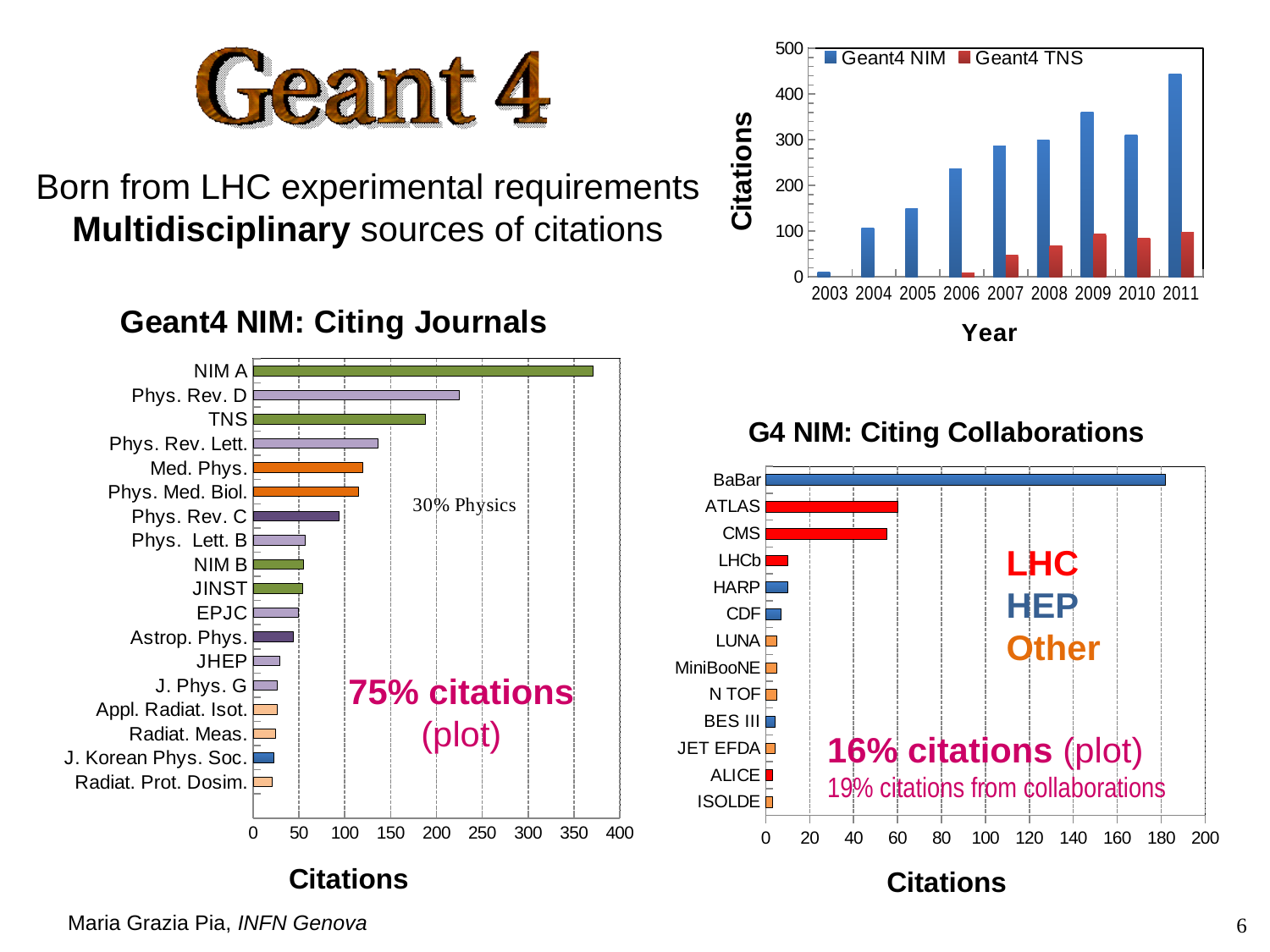
In the chart in the top right of the slide, do the Geant4 NIM citations rise or fall from 2003 to 2007? rise How many years are shown on the x axis of the chart in the top right of the slide? 9 In the chart in the top right of the slide, which year has the highest Geant4 NIM citations? 2011 In the chart in the top right of the slide, is the Geant4 NIM value for 2009 larger or smaller than the value for 2010? larger How many series does the legend of the chart in the top right of the slide list? 2 In the chart in the top right of the slide, is the Geant4 NIM value for 2011 greater or less than 400? greater What kind of chart is 'Geant4 NIM: Citing Journals'? bar chart How many journals are listed in the 'Geant4 NIM: Citing Journals' chart? 18 In the 'G4 NIM: Citing Collaborations' chart, is the value for ATLAS greater or less than 80? less In the 'Geant4 NIM: Citing Journals' chart, which journal has the most citations? NIM A In the 'G4 NIM: Citing Collaborations' chart, which collaboration has the most citations? BaBar In the 'Geant4 NIM: Citing Journals' chart, is the value for Phys. Rev. D greater or less than 200? greater